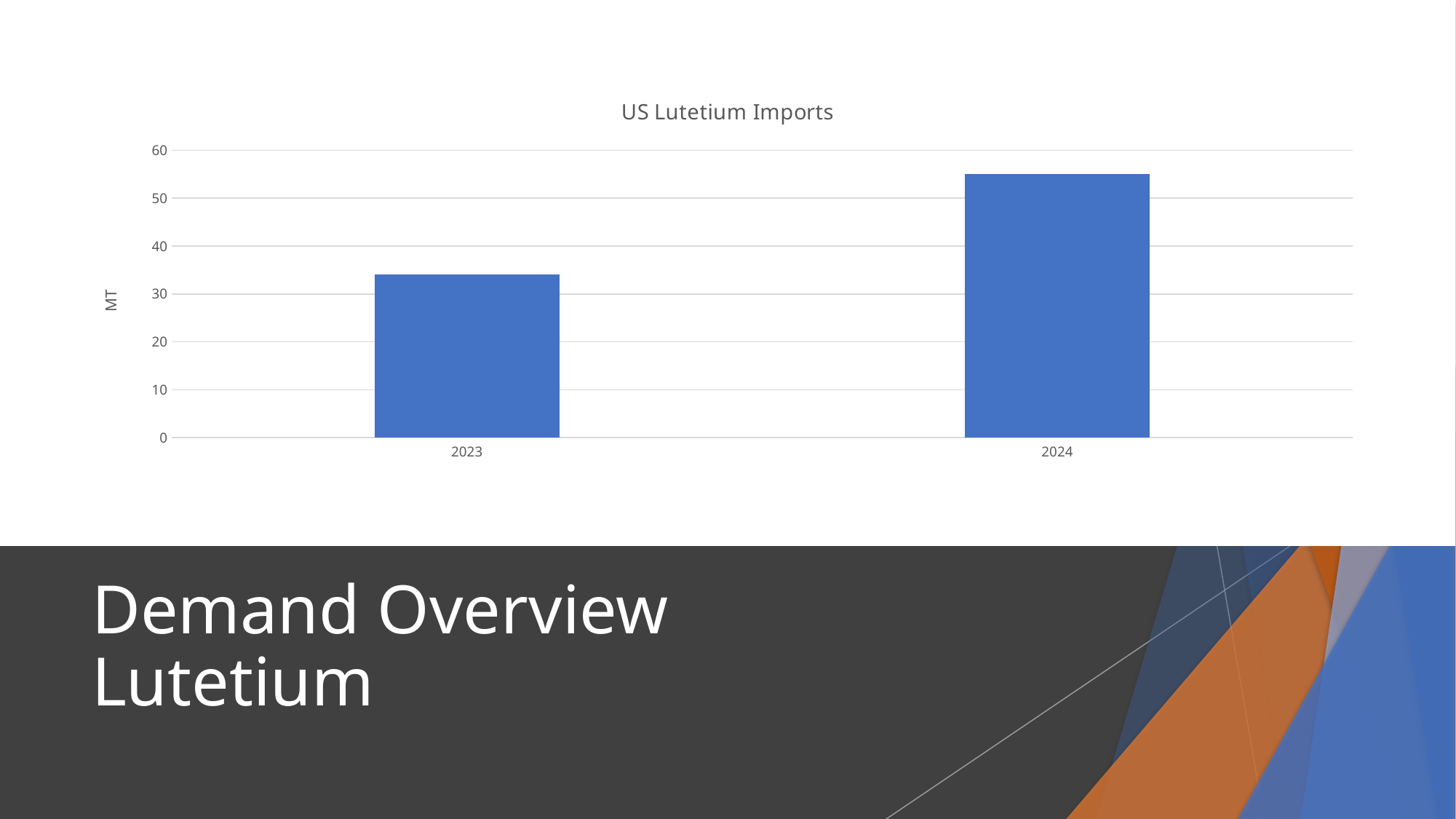
What type of chart is shown on the slide? bar chart What is the title of the chart? US Lutetium Imports Do the values rise or fall from 2023 to 2024? rise What is the label on the vertical axis of the chart? MT Which is larger, the value for 2023 or the value for 2024? 2024 Is the value for 2023 greater or less than 40? less Which year has the lowest US lutetium imports? 2023 Is the value for 2023 greater or less than 30? greater How many categories are shown on the x axis of the chart? 2 Is the value for 2024 greater or less than 60? less Which year has the highest US lutetium imports? 2024